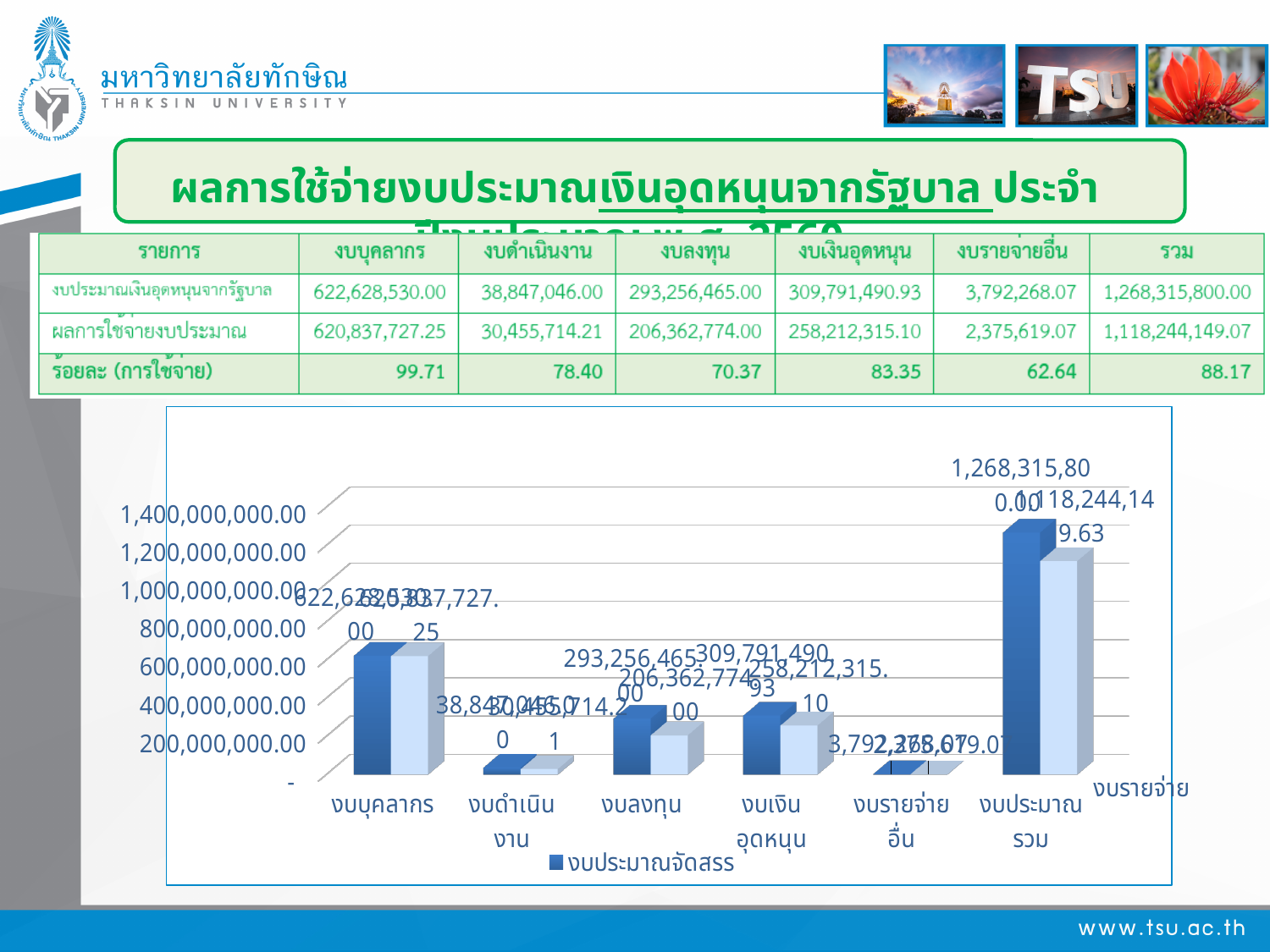
What is the งบประมาณจัดสรร value for งบรายจ่ายอื่น in the chart? 3,792,268.07 Which category has the highest งบประมาณจัดสรร bar in the chart? งบประมาณรวม What is the difference between the งบประมาณจัดสรร values for งบบุคลากร and งบลงทุน? 329,372,065.00 How many categories are shown along the x axis of the chart? 6 What is the งบประมาณจัดสรร value for งบบุคลากร in the chart? 622,628,530.00 What legend entry is shown below the chart? งบประมาณจัดสรร What kind of chart is shown on the slide? bar chart Is the งบประมาณจัดสรร value for งบบุคลากร greater or less than 400,000,000.00? greater Which has the larger งบประมาณจัดสรร value, งบบุคลากร or งบลงทุน? งบบุคลากร Which category has the lowest งบประมาณจัดสรร bar in the chart? งบรายจ่ายอื่น What is the งบประมาณจัดสรร value for งบประมาณรวม in the chart? 1,268,315,800.00 What is the งบประมาณจัดสรร value for งบลงทุน in the chart? 293,256,465.00